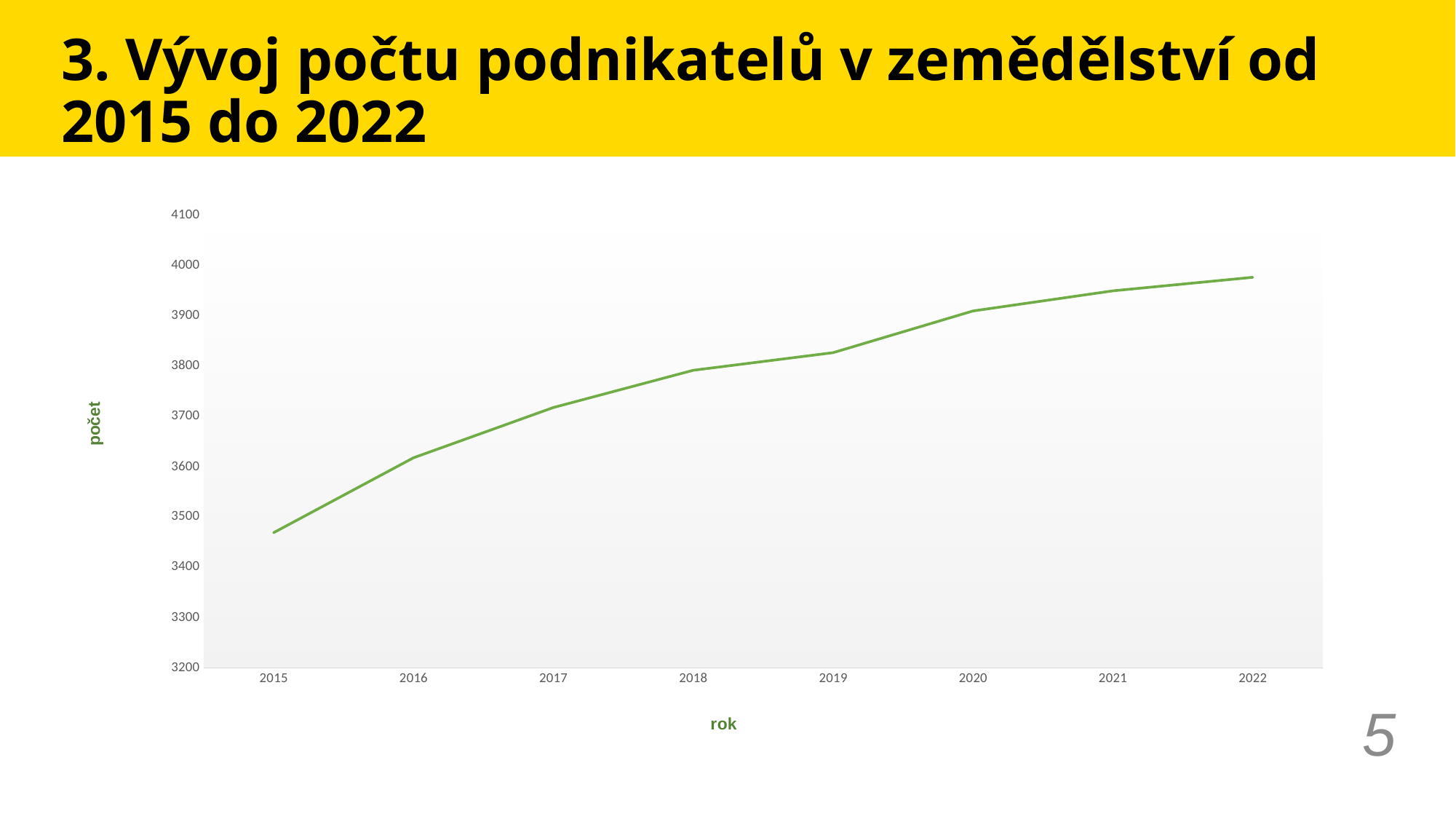
Is the value for 2022 greater or less than 4000? less What is the label of the y axis? počet Is the value for 2015 greater or less than 3500? less How many years are plotted on the x axis of the chart? 8 Is the value for 2019 greater or less than 3800? greater Which year has the lowest value in the chart? 2015 What kind of chart is shown on the slide? line chart Which year has the highest value in the chart? 2022 Which is larger, the value for 2020 or the value for 2018? 2020 What is the label of the x axis? rok Do the values rise or fall from 2015 to 2022? rise